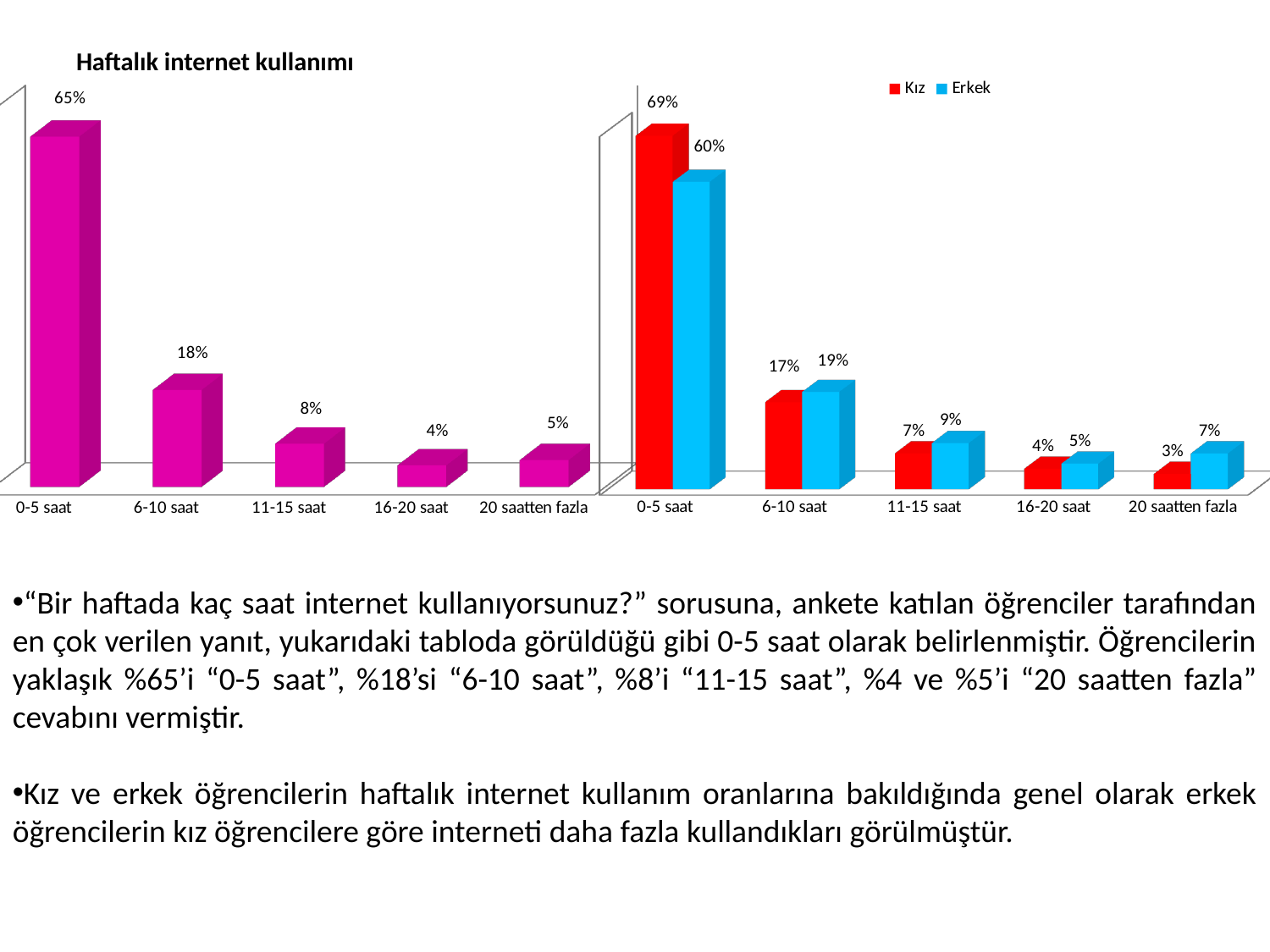
In the left chart titled 'Haftalık internet kullanımı', which category has the lowest value? 16-20 saat In the left chart titled 'Haftalık internet kullanımı', what is the value for '0-5 saat'? 65% In the right chart, what colour are the 'Kız' bars? red In the right chart, which is larger for '20 saatten fazla', 'Kız' or 'Erkek'? Erkek In the right chart, what is the 'Kız' value for '0-5 saat'? 69% What kind of chart is the left chart titled 'Haftalık internet kullanımı'? bar chart In the left chart titled 'Haftalık internet kullanımı', what is the difference between '6-10 saat' and '11-15 saat'? 10% In the right chart, what is the difference between the 'Kız' and 'Erkek' values for '0-5 saat'? 9% In the left chart titled 'Haftalık internet kullanımı', how many categories are shown on the x axis? 5 In the right chart, how many series does the legend list? 2 In the right chart, what is the 'Erkek' value for '11-15 saat'? 9% In the right chart, which category has the highest 'Erkek' value? 0-5 saat